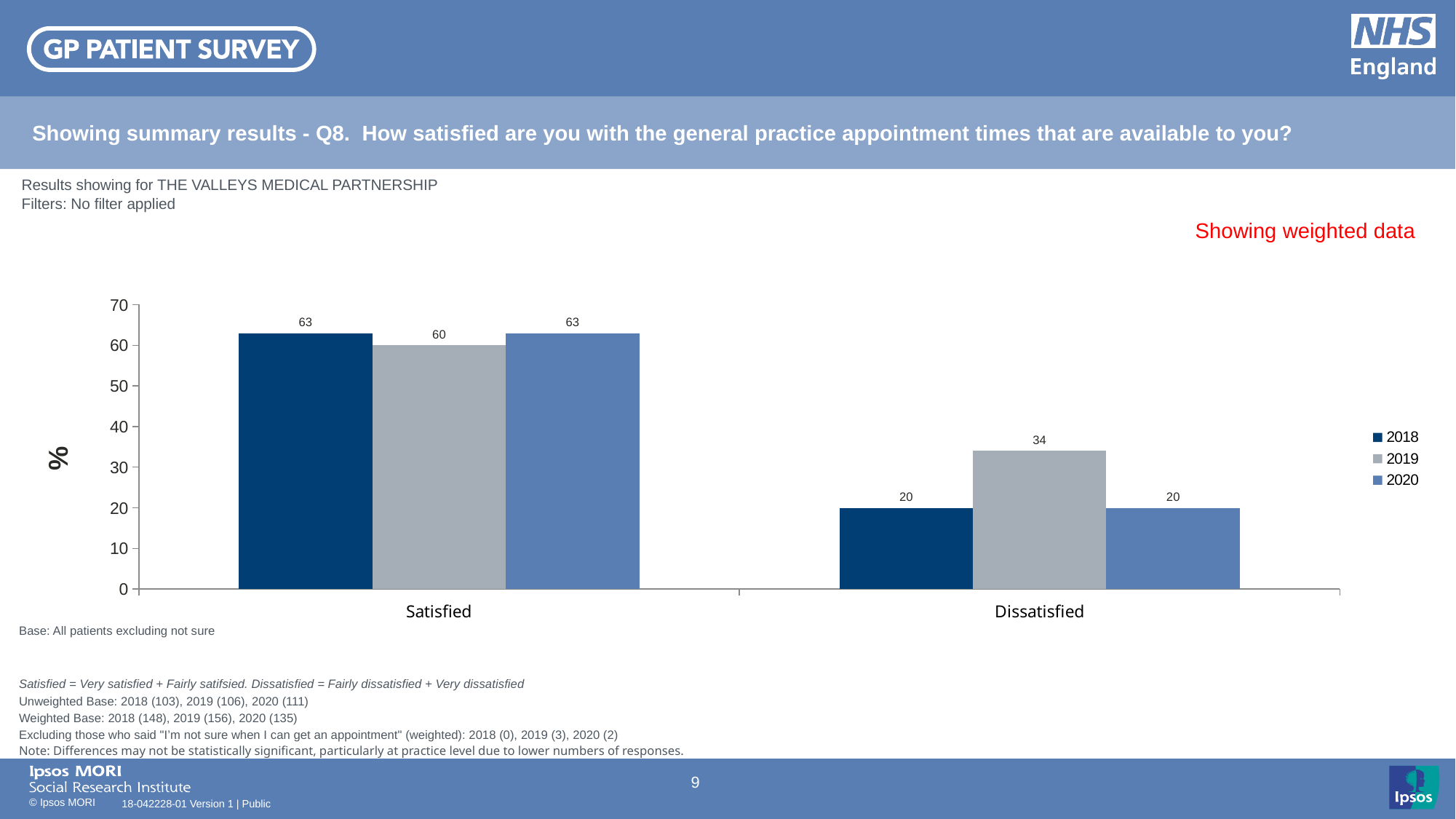
What is the value for 2019 in the Satisfied category? 60 What is the value for 2020 in the Satisfied category? 63 What kind of chart is shown on the slide? Bar chart Which year has the highest value in the Dissatisfied category? 2019 What is the difference between the 2018 and 2019 values in the Satisfied category? 3 Which is larger: the 2019 value for Satisfied or the 2019 value for Dissatisfied? Satisfied What is the value for 2019 in the Dissatisfied category? 34 How many series does the legend list? 3 What is the value for 2018 in the Dissatisfied category? 20 How many categories are shown on the x axis? 2 Which year has the lowest value in the Satisfied category? 2019 What is the difference between the 2019 and 2018 values in the Dissatisfied category? 14